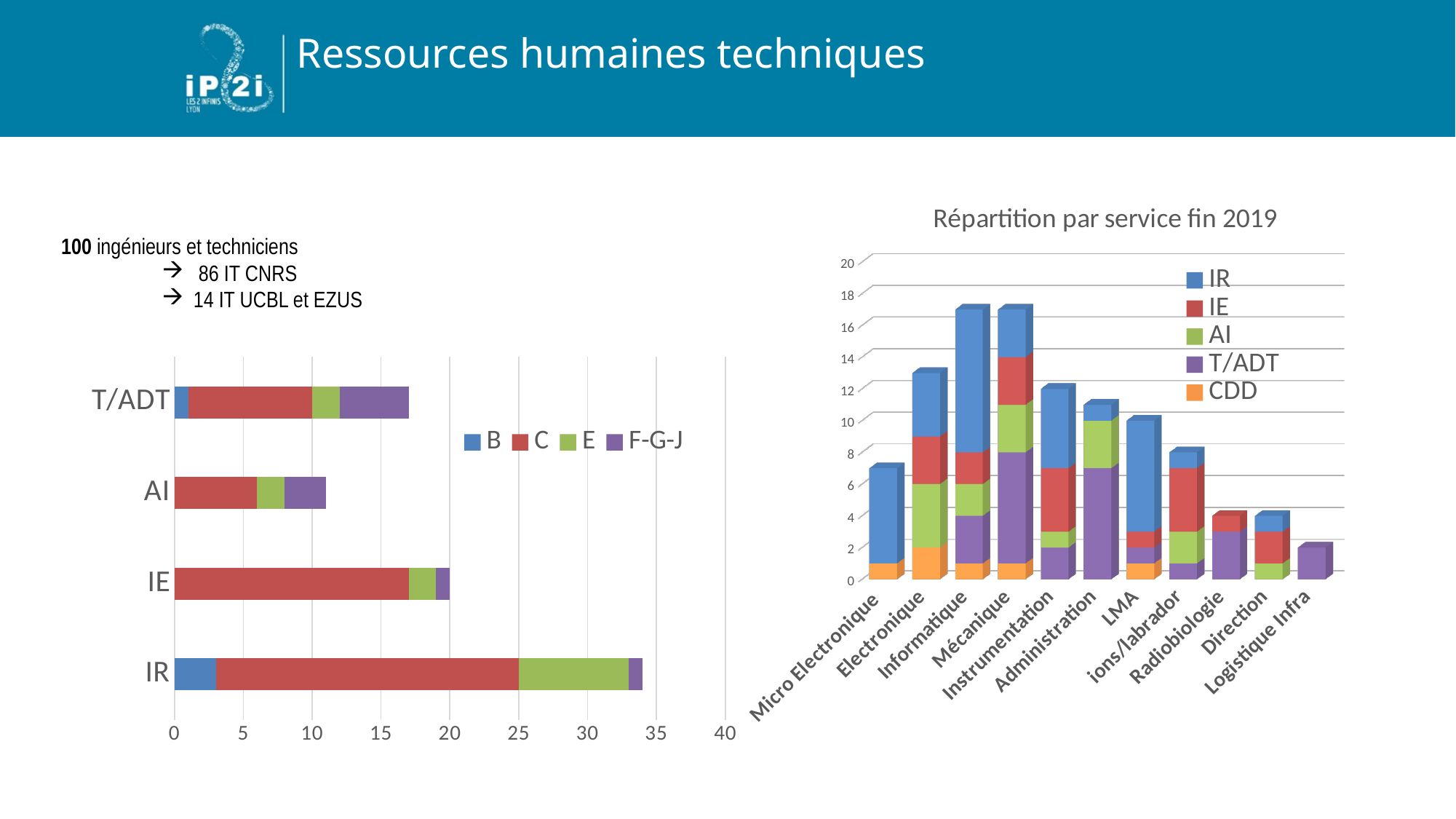
On the chart titled 'Répartition par service fin 2019', is the total for Micro Electronique greater or less than 10? less On the left chart, is the total value for IR greater or less than 30? greater On the left chart, how many categories are shown on the vertical axis? 4 On the left chart, which category has the shortest bar? AI On the left chart, is the total value for AI greater or less than 15? less What kind of chart is the left chart? Stacked bar chart On the chart titled 'Répartition par service fin 2019', how many series does the legend list? 5 On the chart titled 'Répartition par service fin 2019', how many services are shown on the x axis? 11 On the left chart, which category has the longest bar? IR On the chart titled 'Répartition par service fin 2019', which service has the lowest total? Logistique Infra On the left chart, how many series does the legend list? 4 On the chart titled 'Répartition par service fin 2019', which has the larger total, Electronique or LMA? Electronique